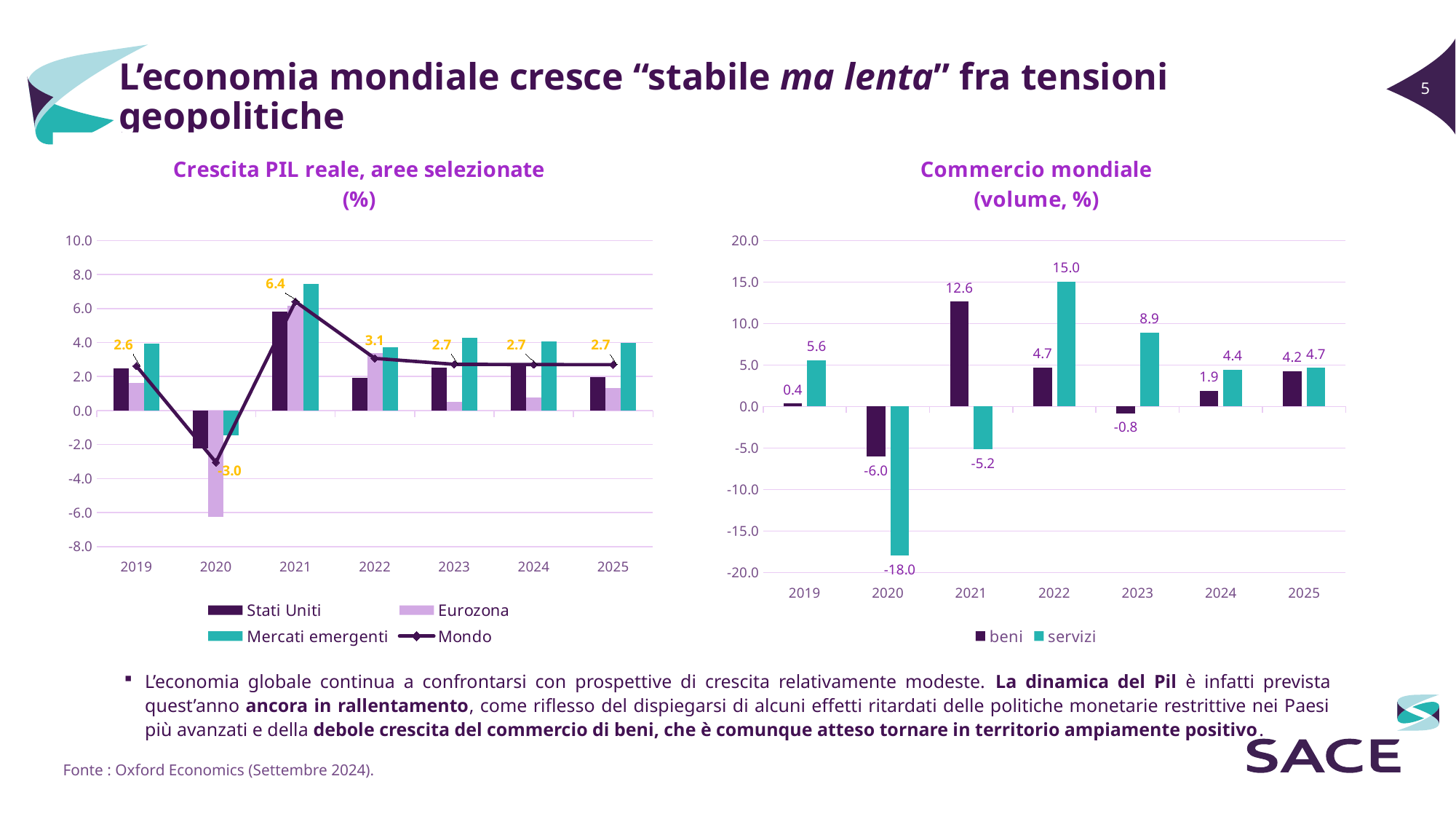
In the 'Crescita PIL reale, aree selezionate (%)' chart, what is the value of the Mondo line in 2021? 6.4 In the 'Commercio mondiale (volume, %)' chart, which year has the lowest value for servizi? 2020 How many years are shown on the x axis of the 'Crescita PIL reale, aree selezionate (%)' chart? 7 In the 'Commercio mondiale (volume, %)' chart, which year has the highest value for servizi? 2022 In the 'Crescita PIL reale, aree selezionate (%)' chart, what is the value of the Mondo line in 2020? -3.0 In the 'Crescita PIL reale, aree selezionate (%)' chart, does the Mondo line rise or fall from 2021 to 2023? fall In the 'Commercio mondiale (volume, %)' chart, what is the value for beni in 2021? 12.6 What kind of chart is the 'Commercio mondiale (volume, %)' chart? bar chart In the 'Crescita PIL reale, aree selezionate (%)' chart, is the value for Eurozona in 2020 greater or less than -4.0? less How many series does the legend of the 'Crescita PIL reale, aree selezionate (%)' chart list? 4 In the 'Commercio mondiale (volume, %)' chart, what is the difference between servizi and beni in 2022? 10.3 In the 'Commercio mondiale (volume, %)' chart, which is larger in 2021, beni or servizi? beni